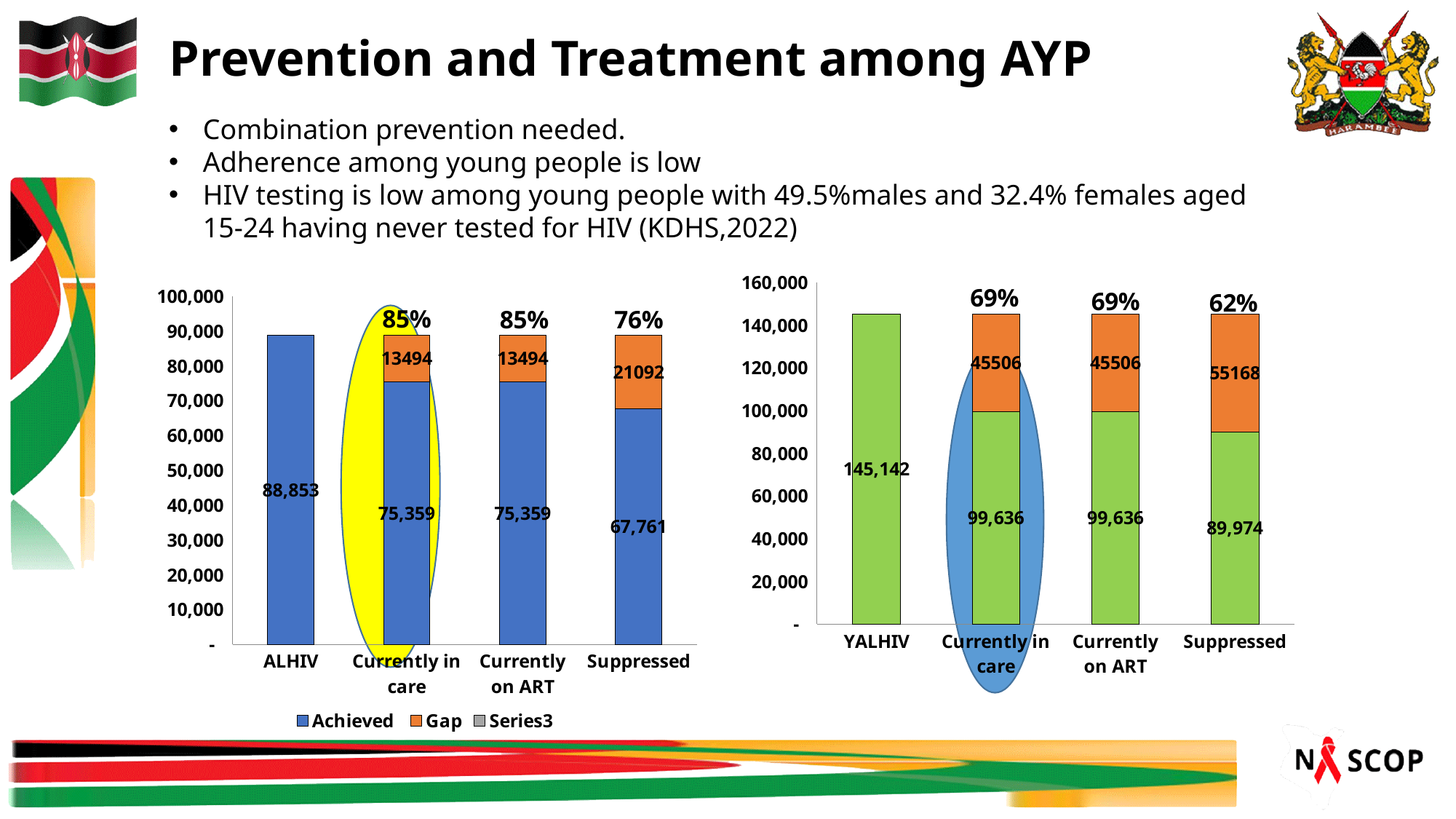
In the right chart, what is the Gap value for Suppressed? 55168 In the left chart, what is the Gap value for Currently in care? 13494 In the right chart, what is the value shown for YALHIV? 145,142 In the left chart, which category has the lowest Achieved value? Suppressed How many series does the legend of the left chart list? 3 In the right chart, is the Achieved value for Suppressed greater or less than 100,000? less In the left chart, what is the difference between the ALHIV value and the Achieved value for Suppressed? 21,092 In the left chart, what is the Achieved value for Suppressed? 67,761 How many categories are shown on the x axis of the left chart? 4 What type of chart is the right chart? Bar chart In the right chart, what is the total of the stacked Currently on ART bar (Achieved plus Gap)? 145,142 In the right chart, what percentage is shown above the Suppressed bar? 62%